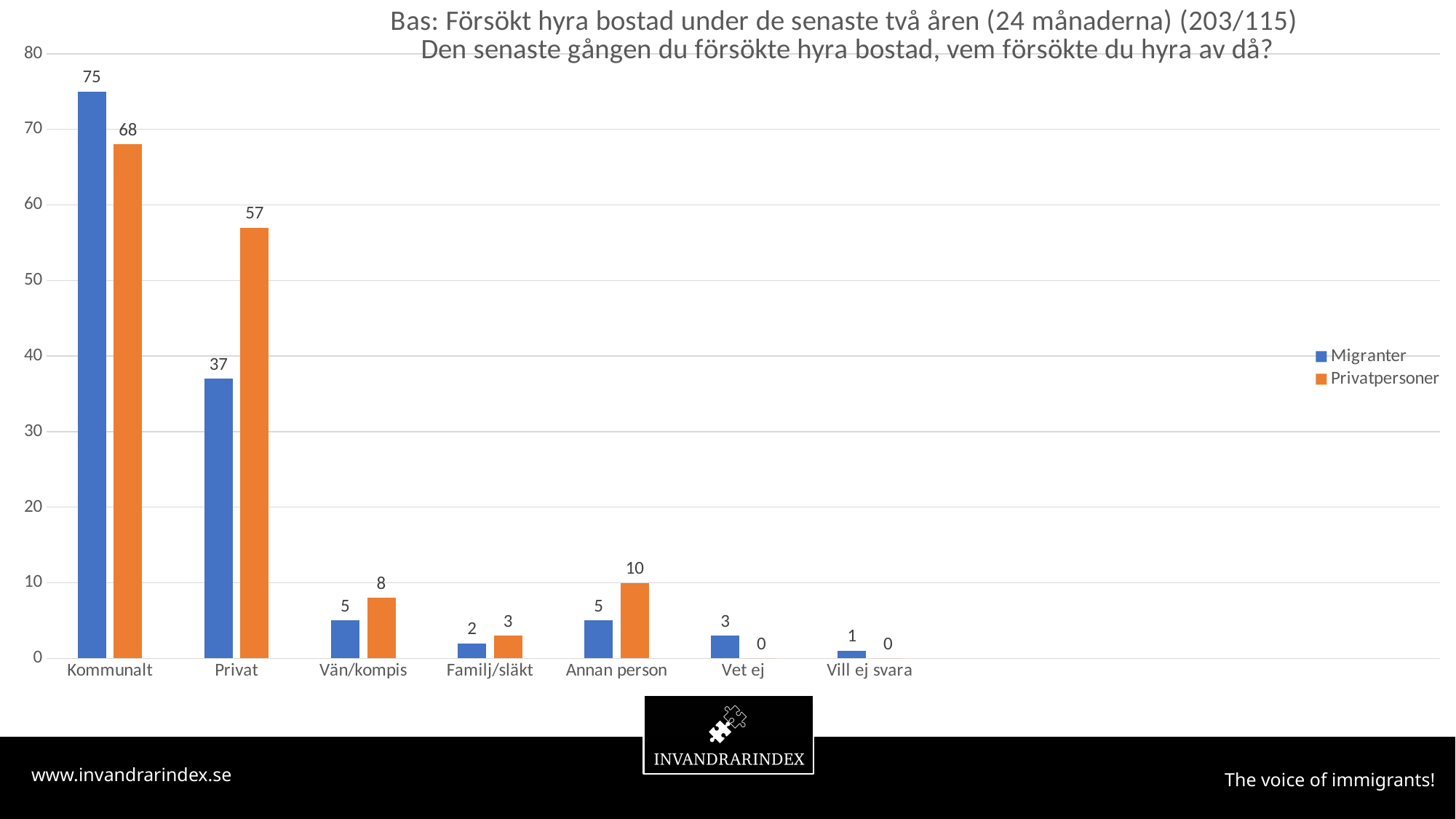
What is the value for Privatpersoner in the Annan person category? 10 What is the difference between the Migranter and Privatpersoner values for Privat? 20 How many series does the legend list? 2 Which category has the highest value for Migranter? Kommunalt What is the value for Privatpersoner in the Privat category? 57 Is the value for Privatpersoner in Kommunalt greater or less than 70? less What kind of chart is shown on the slide? bar chart Which is larger for Vän/kompis: the Migranter value or the Privatpersoner value? Privatpersoner What is the value for Migranter in the Kommunalt category? 75 How many categories are shown on the x axis? 7 Which category has the lowest value for Migranter? Vill ej svara Which colour represents the Privatpersoner series? orange